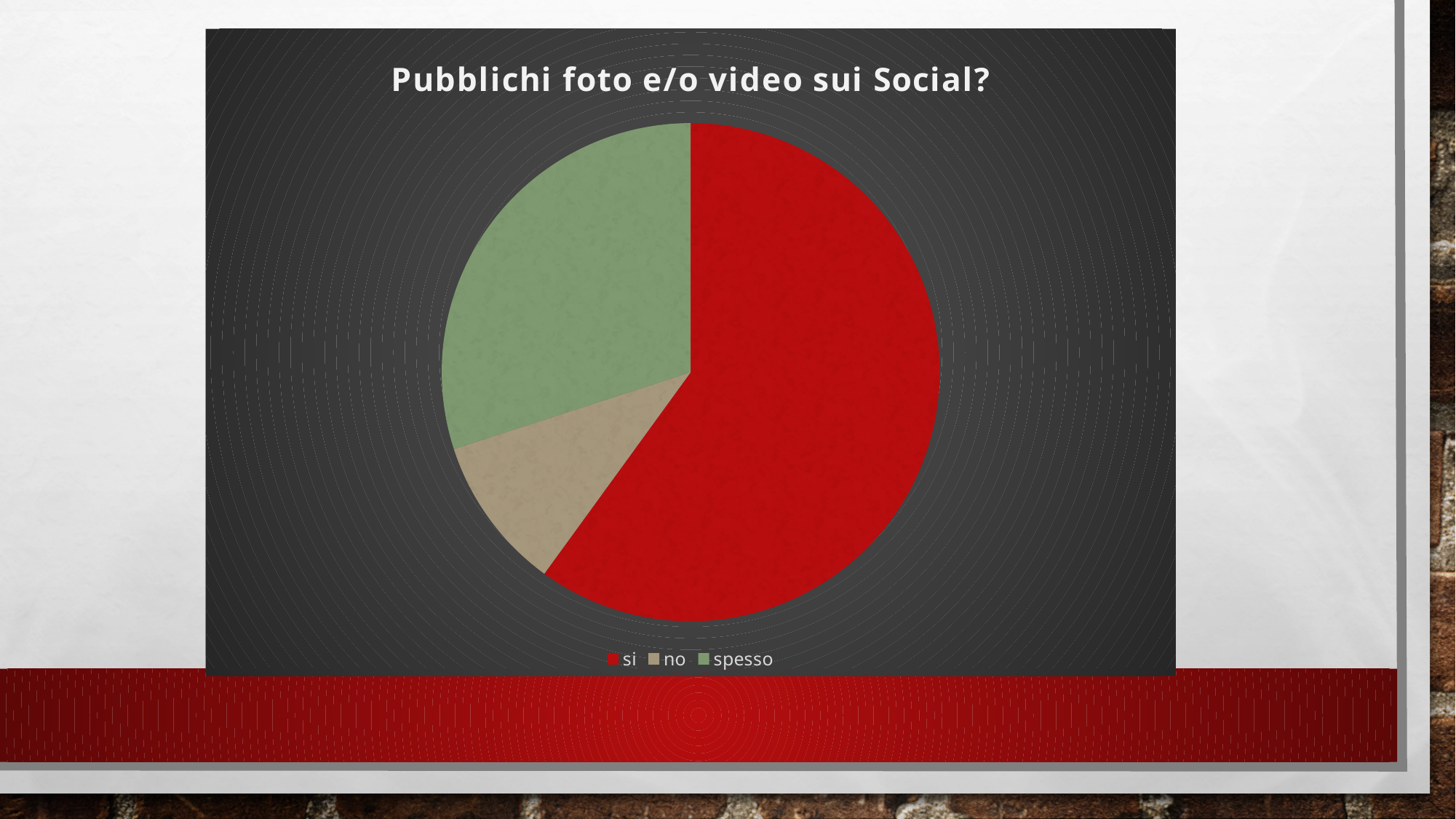
Which category has the smallest slice of the pie? no What kind of chart is shown on the slide? pie chart Which categories are listed in the legend? si, no, spesso What is the title of the chart? Pubblichi foto e/o video sui Social? Which slice is larger, "spesso" or "no"? spesso How many slices does the pie chart have? 3 Which category has the largest slice of the pie? si What colour is the slice for "si"? red Which slice is larger, "si" or "spesso"? si